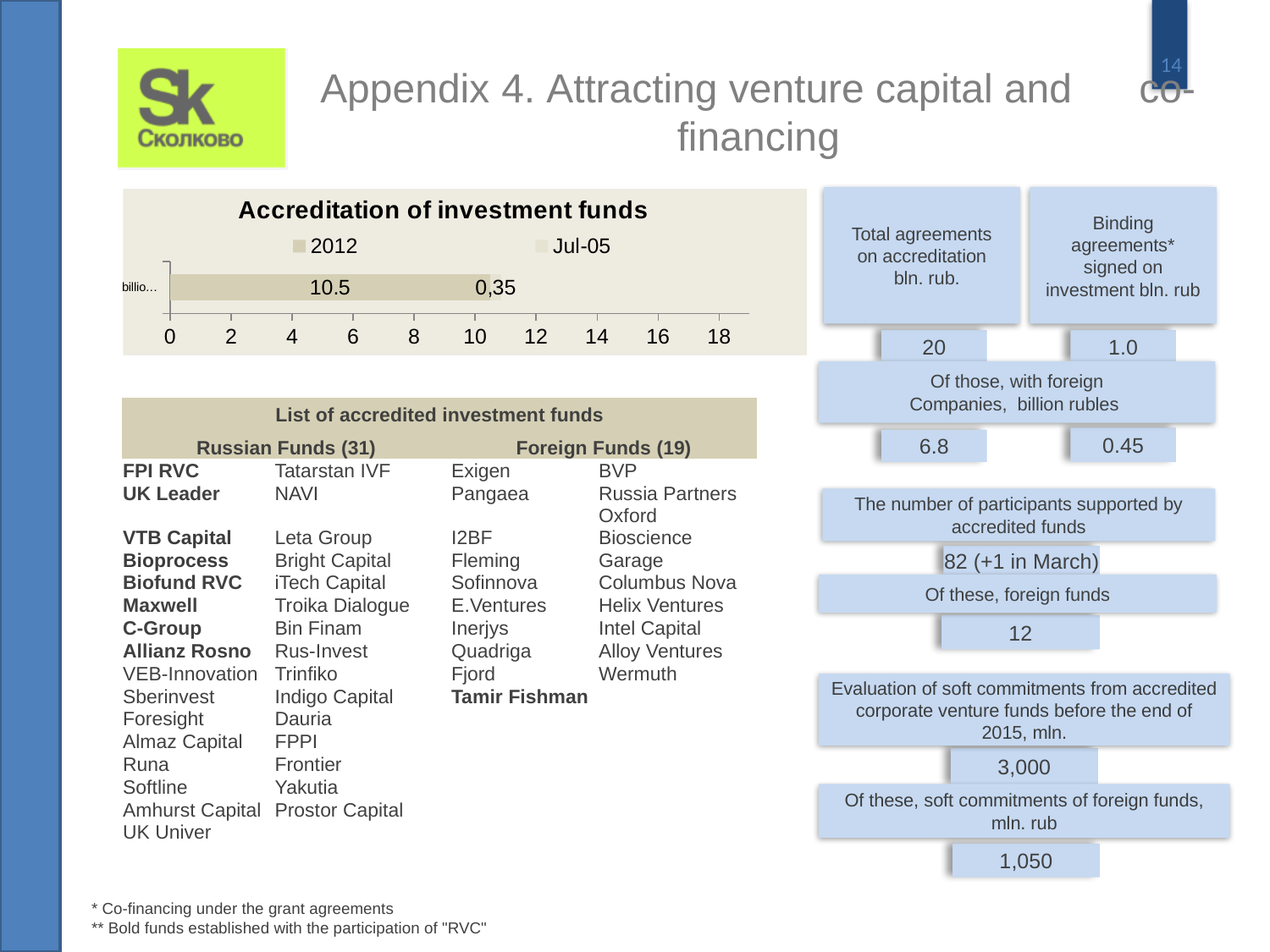
What type of chart is shown under the title 'Accreditation of investment funds'? bar chart How many categories are plotted on the y axis of the 'Accreditation of investment funds' chart? 1 In the 'Accreditation of investment funds' chart, is the value for 2012 greater or less than 8? greater In the 'Accreditation of investment funds' chart, what is the value labelled for the Jul-05 series? 0,35 In the 'Accreditation of investment funds' chart, which series has the highest value? 2012 How many series does the legend of the 'Accreditation of investment funds' chart list? 2 In the 'Accreditation of investment funds' chart, what is the value labelled for the 2012 series? 10.5 In the 'Accreditation of investment funds' chart, what is the difference between the 2012 value and the Jul-05 value? 10.15 In the 'Accreditation of investment funds' chart, which series has the larger value, 2012 or Jul-05? 2012 In the 'Accreditation of investment funds' chart, which series has the smallest value? Jul-05 What is the title of the chart on the slide? Accreditation of investment funds What are the two legend entries of the 'Accreditation of investment funds' chart? 2012 and Jul-05